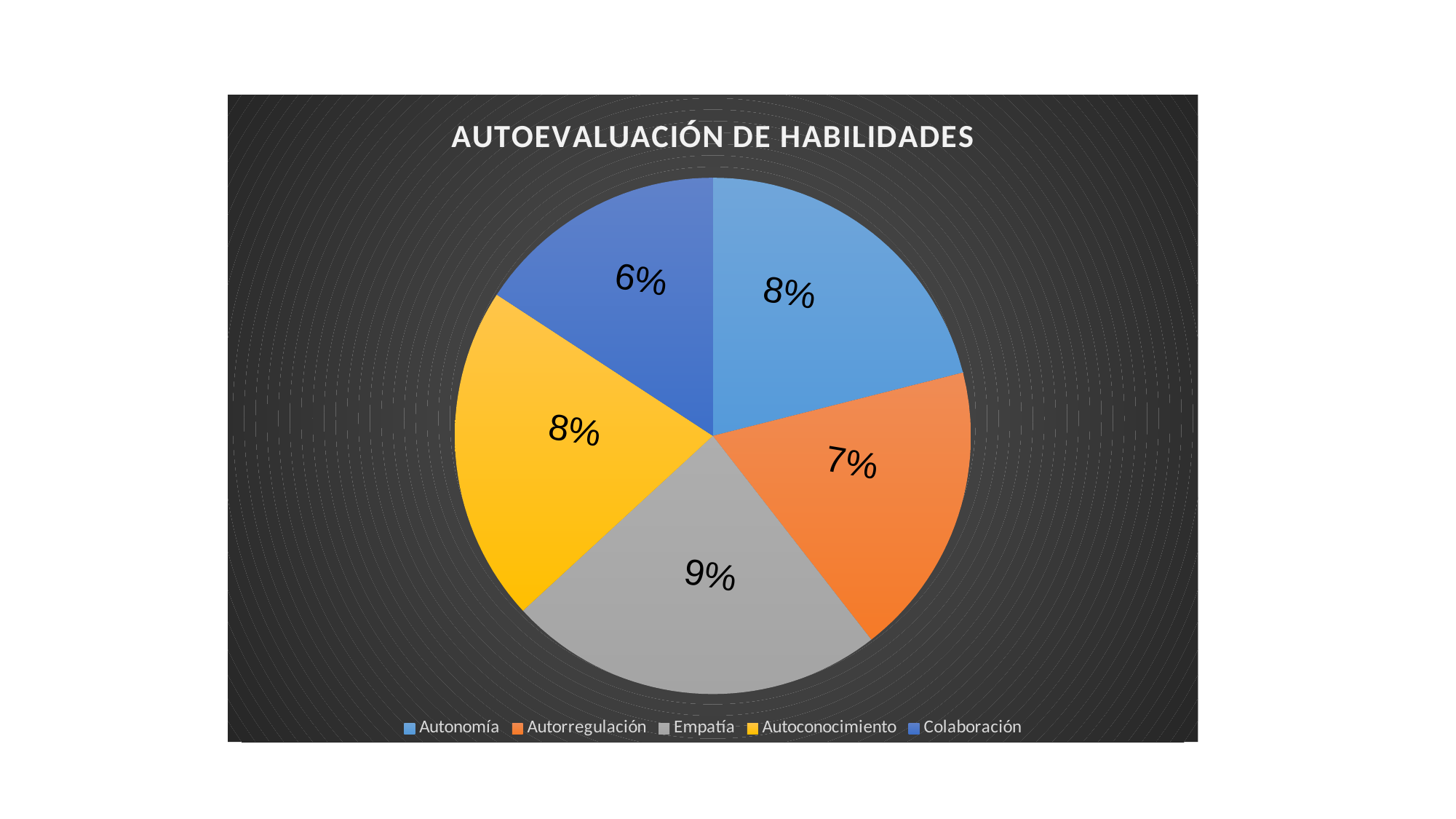
What value is shown for Autorregulación? 7% Which category has the largest slice? Empatía What is the difference between the values for Empatía and Colaboración? 3% Which colour represents Autoconocimiento in the legend? yellow Which is larger, Empatía or Autorregulación? Empatía How many slices does the pie chart have? 5 What value is shown for Empatía? 9% Which category has the smallest slice? Colaboración What is the title of the chart? AUTOEVALUACIÓN DE HABILIDADES What value is shown for Colaboración? 6% What type of chart is shown on the slide? pie chart What value is shown for Autonomía? 8%